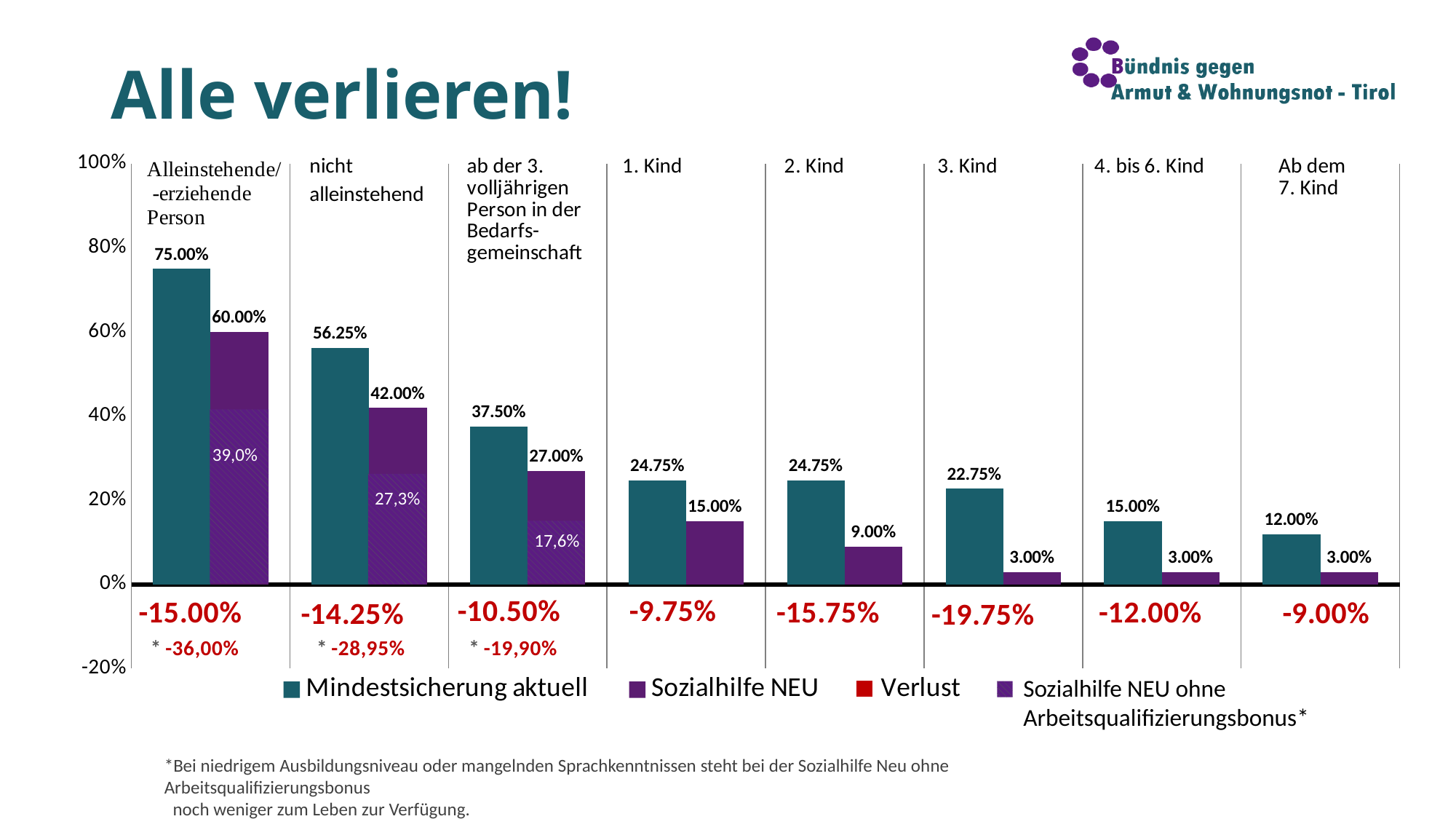
What is the title of the slide? Alle verlieren! Which category has the lowest Mindestsicherung aktuell value? Ab dem 7. Kind Which category has the highest Mindestsicherung aktuell value? Alleinstehende/-erziehende Person What is the Mindestsicherung aktuell value for 'nicht alleinstehend'? 56.25% What Verlust value is shown for '3. Kind'? -19.75% What is the Sozialhilfe NEU ohne Arbeitsqualifizierungsbonus value for 'Alleinstehende/-erziehende Person'? 39,0% What is the difference between the Mindestsicherung aktuell and Sozialhilfe NEU values for '2. Kind'? 15.75% How many categories are shown on the x axis? 8 What is the Sozialhilfe NEU value for '1. Kind'? 15.00% Which is larger: the Sozialhilfe NEU value for '1. Kind' or for '2. Kind'? 1. Kind How many series does the legend list? 4 What kind of chart is shown on the slide? Bar chart